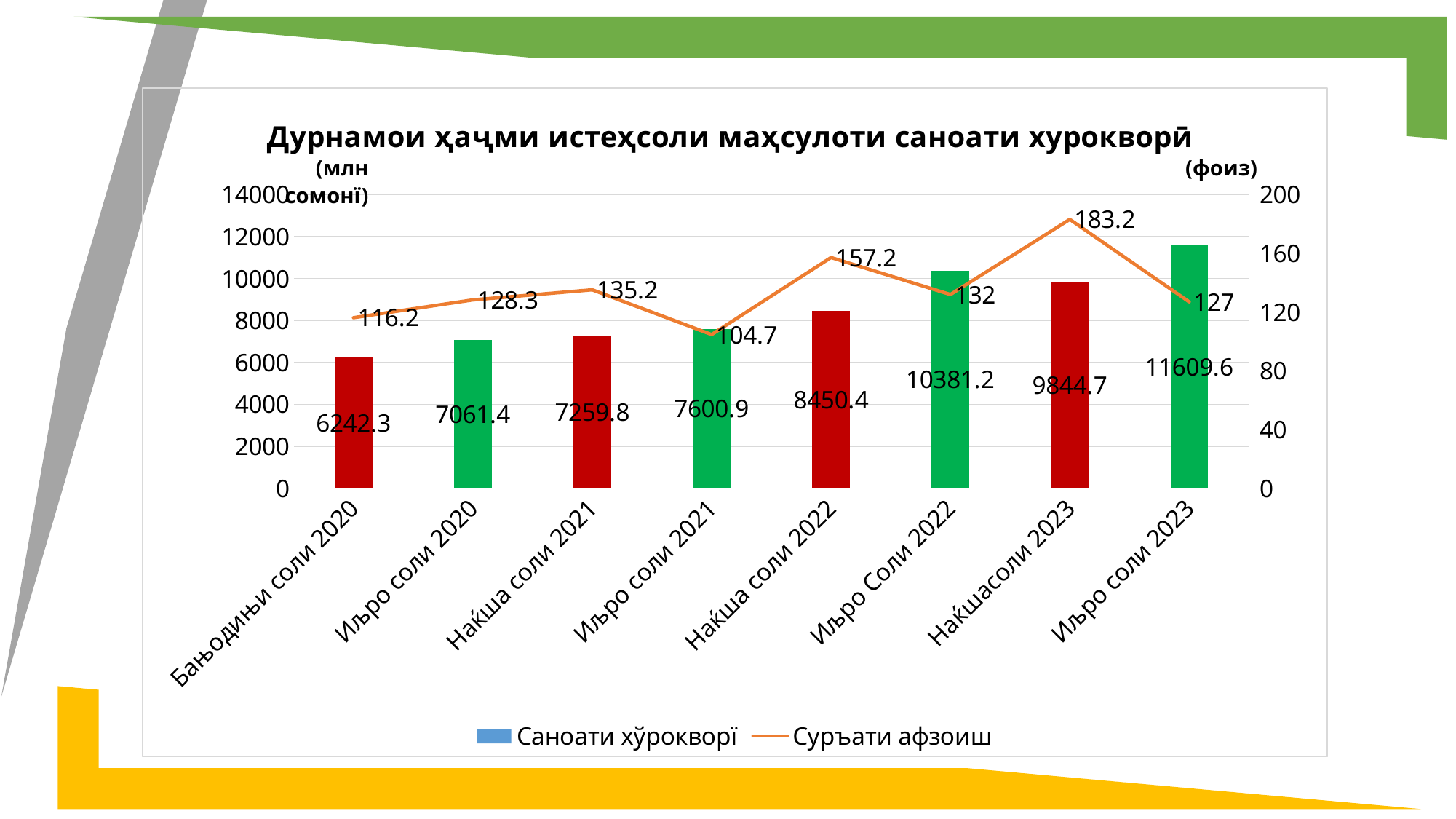
What is the Суръати афзоиш value for Нақшасоли 2023? 183.2 Which category has the highest Саноати хӯрокворӣ bar? Иҷро соли 2023 What is the title of the chart? Дурнамои ҳаҷми истеҳсоли маҳсулоти саноати хурокворӣ What is the value of the Саноати хӯрокворӣ bar for Иҷро соли 2023? 11609.6 Is the Саноати хӯрокворӣ value for Нақша соли 2022 greater or less than 8000? greater How many categories are shown on the x axis? 8 What kind of chart is shown on the slide? Combined bar and line chart How many series does the legend list? 2 Which is larger, the Саноати хӯрокворӣ value for Иҷро Соли 2022 or for Нақшасоли 2023? Иҷро Соли 2022 What is the difference between the Саноати хӯрокворӣ values for Иҷро Соли 2022 and Нақша соли 2022? 1930.8 Which category has the lowest Суръати афзоиш value? Иҷро соли 2021 What is the Саноати хӯрокворӣ value for Баҳодиҳии соли 2020? 6242.3